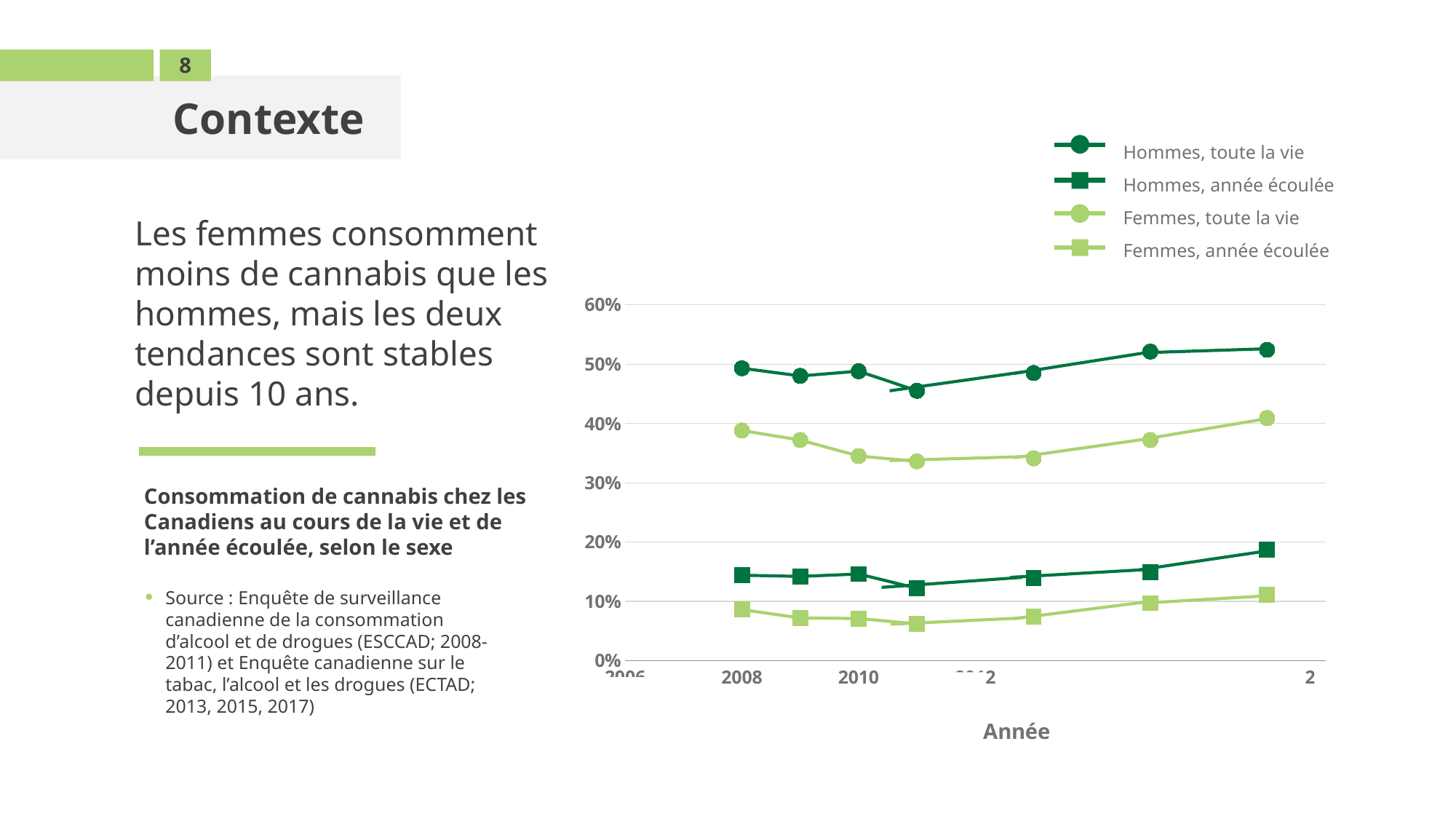
Which series has the highest values across the chart? Hommes, toute la vie What kind of chart is shown on the slide? line chart Is the value for Femmes, toute la vie in 2008 greater or less than 30%? greater Which series has the lowest values across the chart? Femmes, année écoulée Does the Femmes, toute la vie line rise or fall from 2010 to its last point? rises How many data points are plotted for each series? 7 How many series does the chart legend list? 4 Is the value for Hommes, toute la vie in 2008 greater or less than 40%? greater Is the value for Hommes, année écoulée in 2010 greater or less than 20%? less In 2010, which is larger: Hommes, toute la vie or Femmes, toute la vie? Hommes, toute la vie What is the title of the chart's x axis? Année